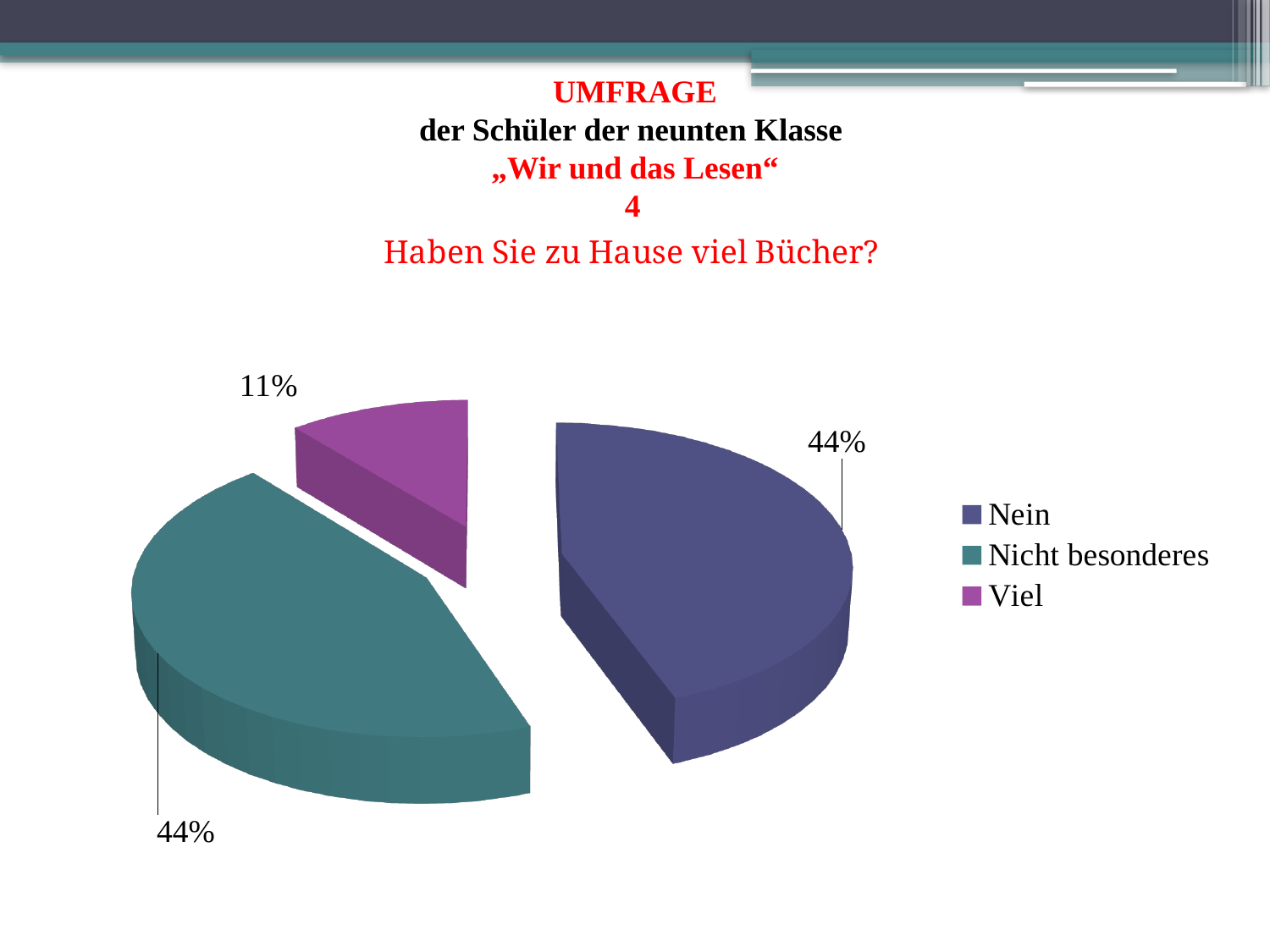
Which legend entry is shown in magenta/purple-pink? Viel How many slices does the pie chart have? 3 What percentage of the pie chart is labelled for the "Viel" slice? 11% What kind of chart is shown on the slide? Pie chart Do the "Nein" and "Nicht besonderes" slices show the same percentage? Yes, both 44% What is the difference in percentage points between the "Nein" slice and the "Viel" slice? 33 percentage points Which category has the smallest share of the pie? Viel Which is larger, the "Nicht besonderes" slice or the "Viel" slice? Nicht besonderes What percentage does the "Nicht besonderes" slice show? 44% How many entries does the legend list? 3 What question is the pie chart answering, according to the slide heading? Haben Sie zu Hause viel Bücher? What percentage does the "Nein" slice show? 44%